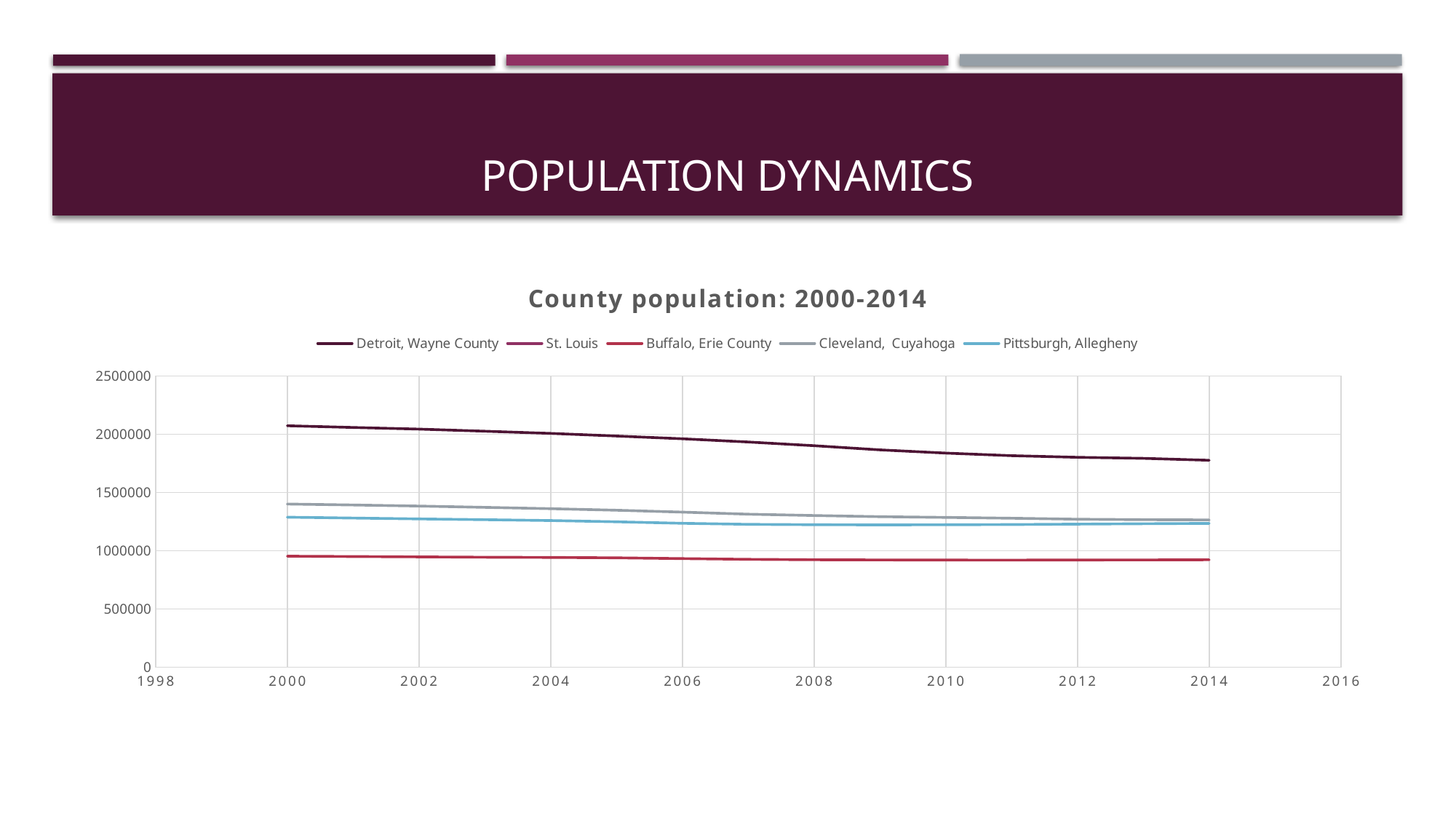
Is the value for Detroit, Wayne County in 2000 greater or less than 2000000? greater What kind of chart is shown on the slide? line chart What is the title of the chart? County population: 2000-2014 Is the value for Cleveland, Cuyahoga in 2000 greater or less than 1500000? less In 2000, which is larger: the value for Cleveland, Cuyahoga or the value for Pittsburgh, Allegheny? Cleveland, Cuyahoga How many series does the legend list? 5 Which series has the highest population throughout the chart? Detroit, Wayne County Does the population of Cleveland, Cuyahoga rise or fall from 2000 to 2014? fall Is the value for Buffalo, Erie County in 2014 greater or less than 1000000? less Does the population of Detroit, Wayne County rise or fall from 2000 to 2014? fall